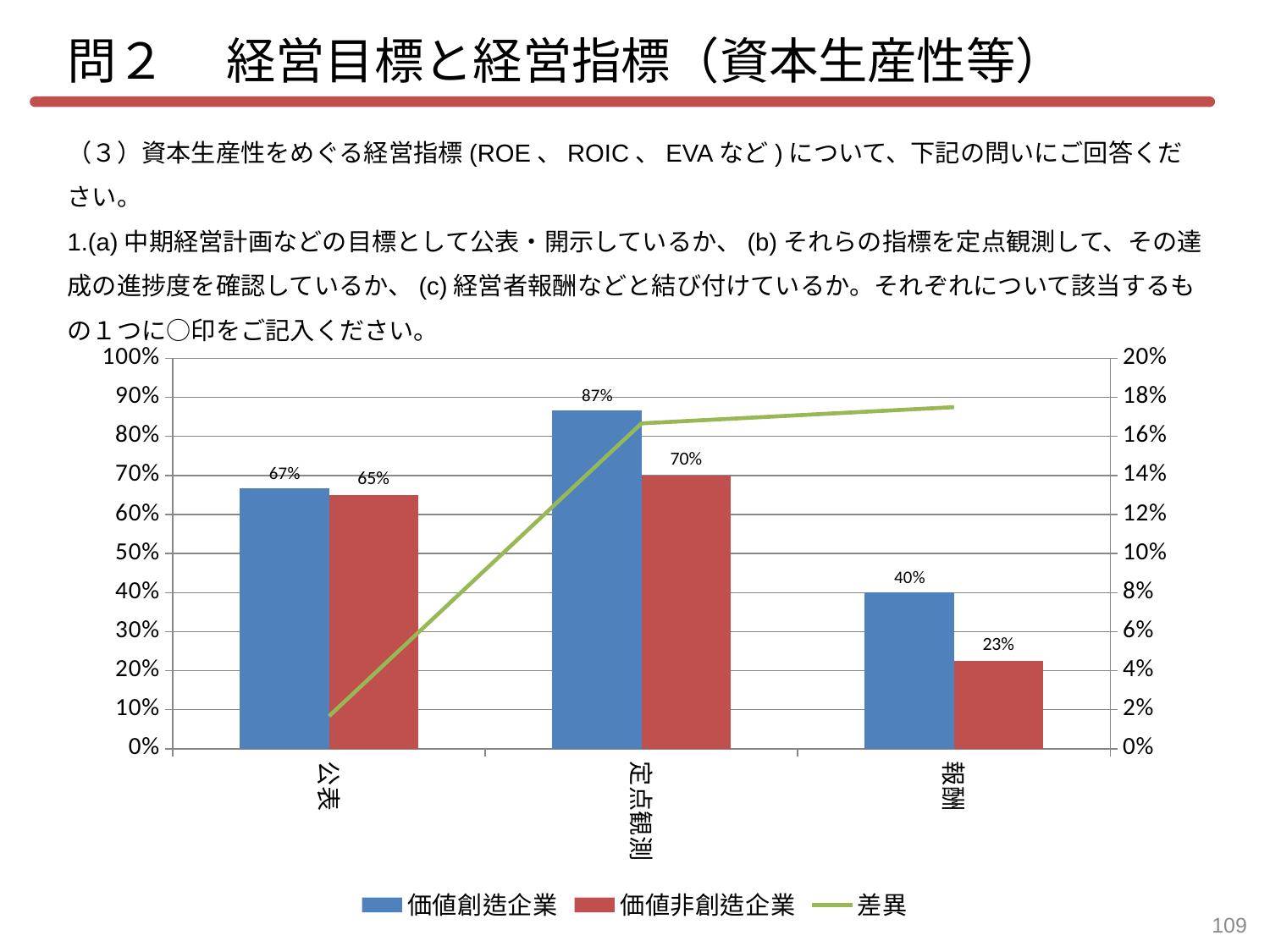
Which is larger in the 定点観測 category, 価値創造企業 or 価値非創造企業? 価値創造企業 What is the value for 価値非創造企業 in the 報酬 category? 23% What is the difference between 価値創造企業 and 価値非創造企業 in the 報酬 category? 17 percentage points Is the 差異 line value for 公表 greater or less than 4% on the right axis? less Which category has the highest value for 価値創造企業? 定点観測 Which category has the lowest value for 価値非創造企業? 報酬 What is the value for 価値非創造企業 in the 公表 category? 65% How many categories are shown on the x axis? 3 Is the 差異 line value for 報酬 greater or less than 16% on the right axis? greater What is the value for 価値創造企業 in the 定点観測 category? 87% How many series does the legend list? 3 Does the 差異 line rise or fall from 公表 to 報酬? rise